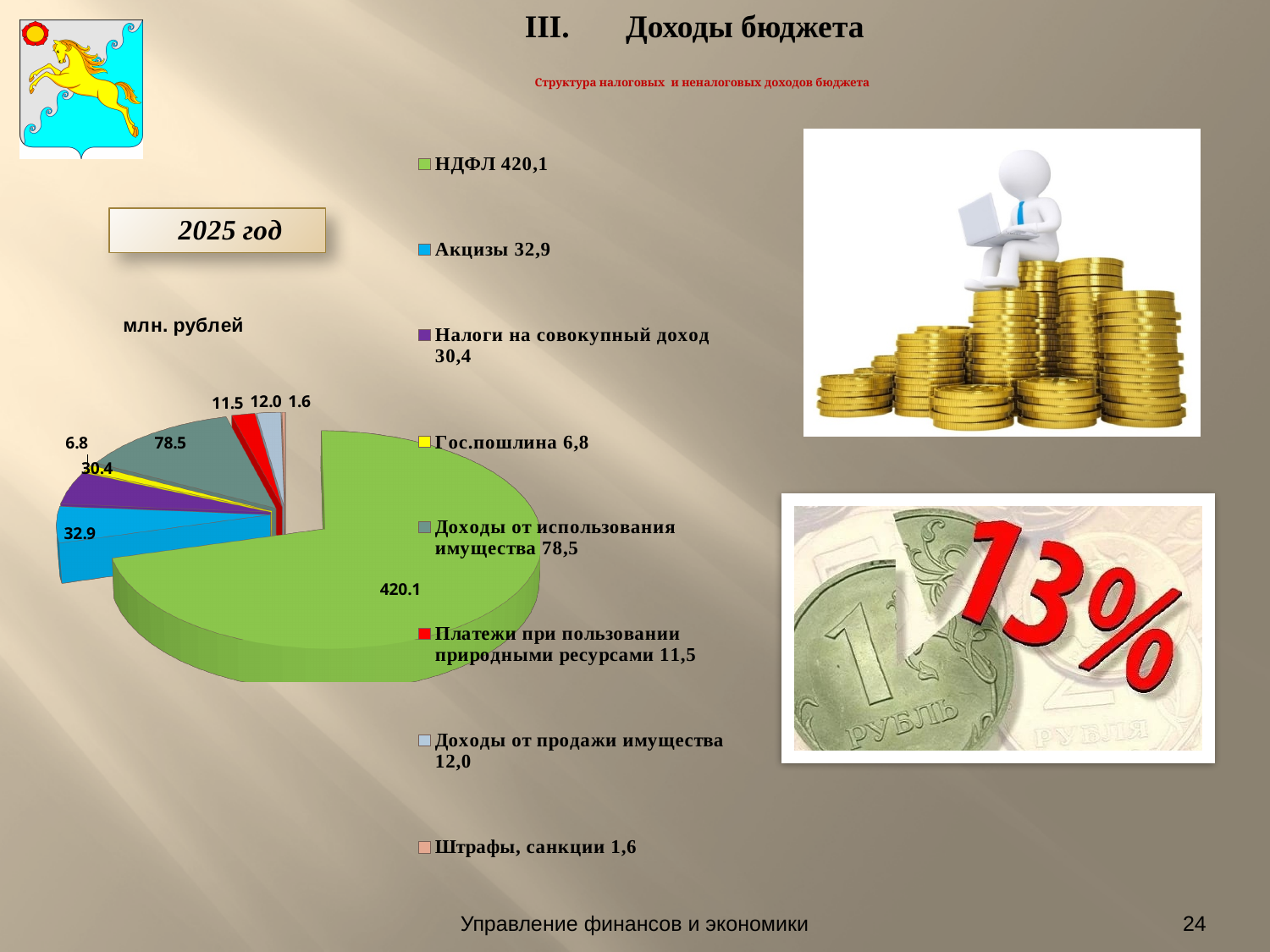
What unit is stated above the pie chart? млн. рублей What is the difference between Доходы от использования имущества and Акцизы? 45.6 Which is larger: Акцизы or Налоги на совокупный доход? Акцизы Which category has the smallest slice of the pie? Штрафы, санкции How many slices does the pie chart have? 8 What type of chart is shown on the slide? Pie chart Which category has the largest slice of the pie? НДФЛ What is the value for Акцизы in the pie chart? 32.9 How many entries does the legend list? 8 What is the value for Штрафы, санкции? 1.6 What is the value for НДФЛ in the pie chart? 420.1 What is the value for Доходы от использования имущества? 78.5